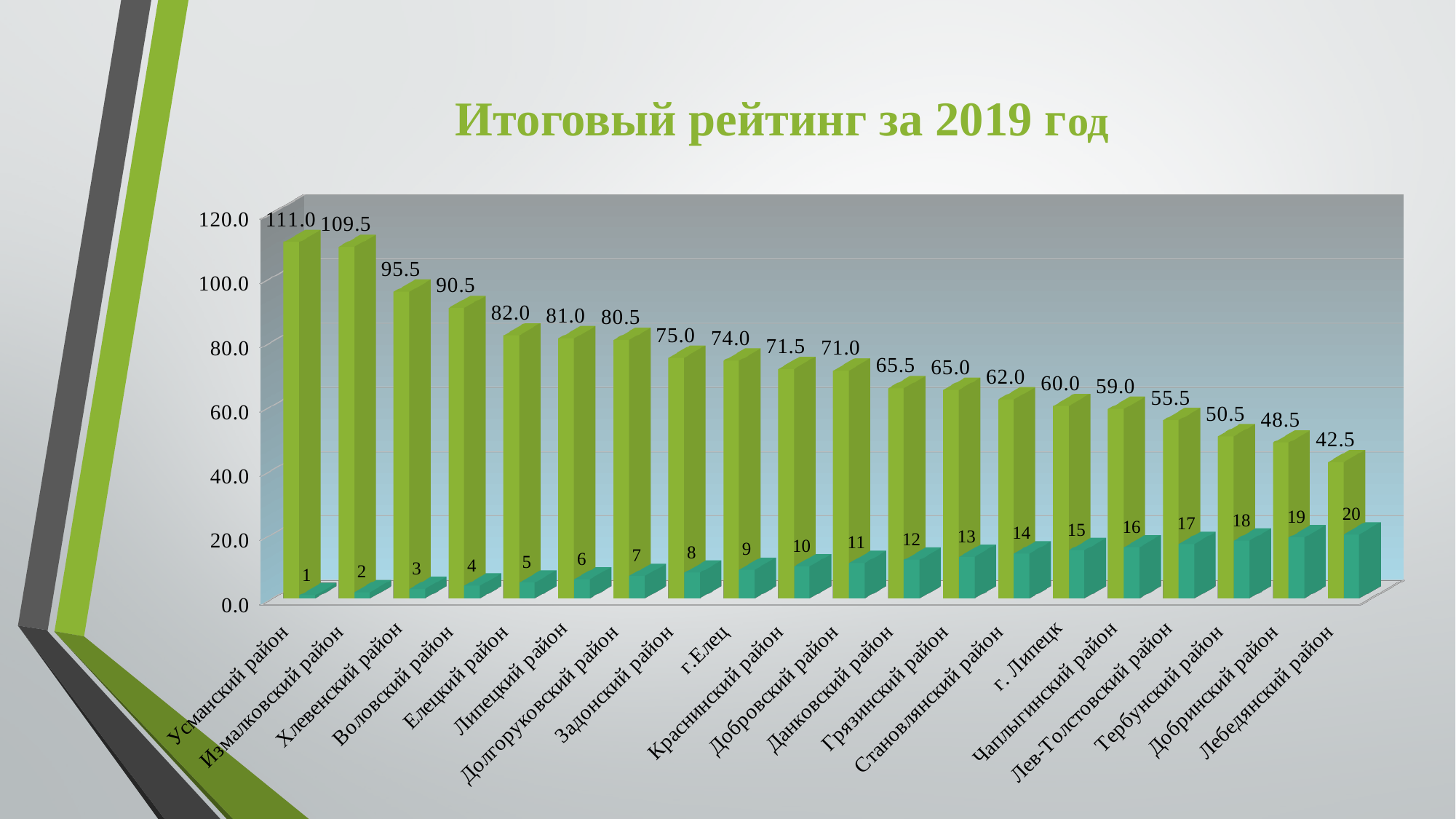
What is the rating value for Усманский район? 111.0 Do the rating values rise or fall from left to right along the x axis? fall What rank number is shown for Тербунский район? 18 What is the rating value for Задонский район? 75.0 How many districts (categories) are shown on the x axis? 20 What is the difference between the rating values of Усманский район and Измалковский район? 1.5 What is the rating value for г. Липецк? 60.0 Which district has the highest rating value? Усманский район What type of chart is shown on the slide? bar chart Which has a higher rating value, Хлевенский район or Воловский район? Хлевенский район What is the title of the chart? Итоговый рейтинг за 2019 год Which district has the lowest rating value? Лебедянский район